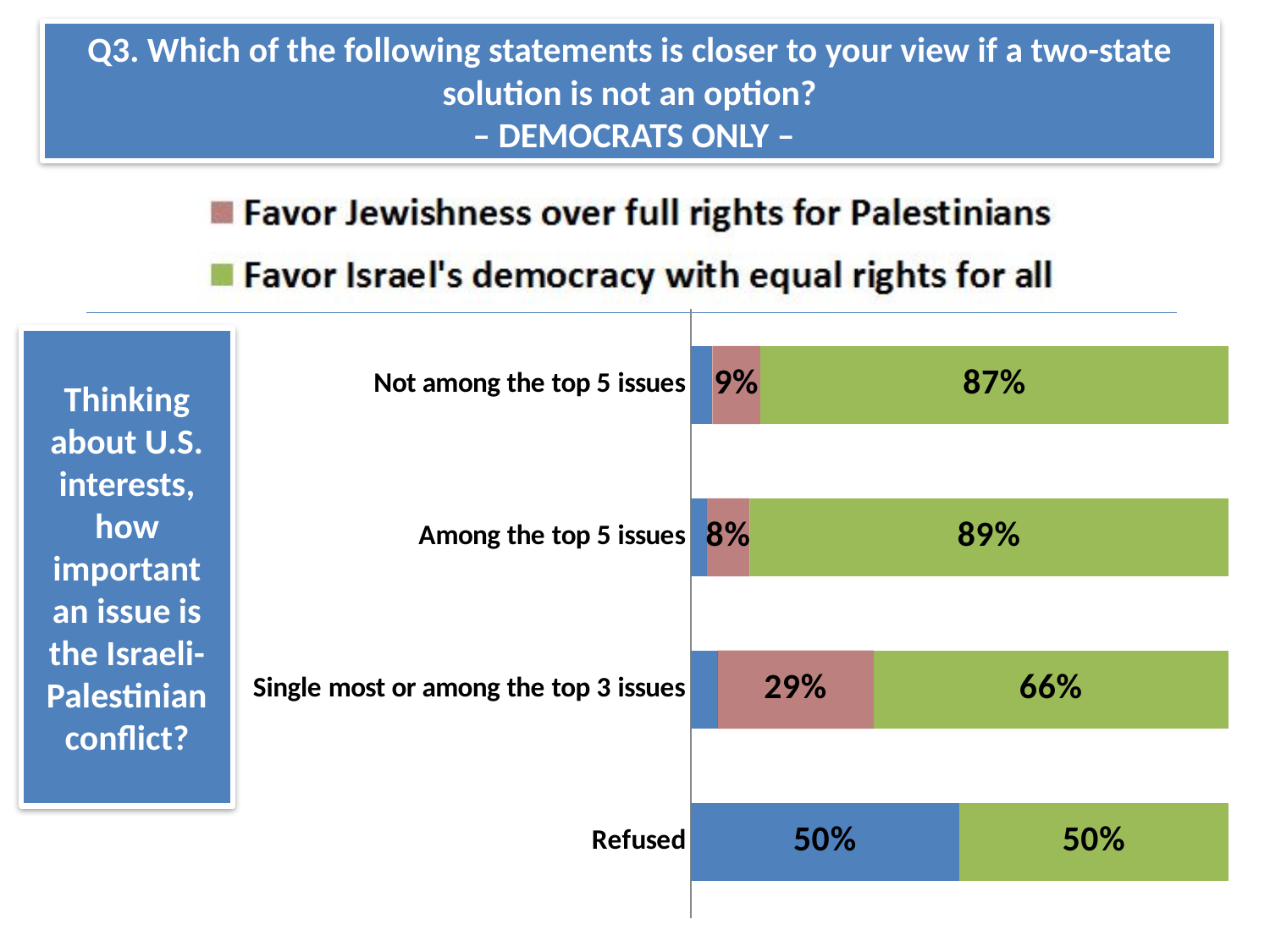
Which category has a larger 'Favor Jewishness over full rights for Palestinians' value: 'Not among the top 5 issues' or 'Single most or among the top 3 issues'? Single most or among the top 3 issues What kind of chart is shown on the slide? Stacked bar chart Which category has the highest value for 'Favor Israel's democracy with equal rights for all'? Among the top 5 issues What percentage of Democrats who say the conflict is not among the top 5 issues favor Israel's democracy with equal rights for all? 87% What is the value for 'Favor Israel's democracy with equal rights for all' in the 'Refused' category? 50% What is the difference in percentage points between the 'Favor Israel's democracy with equal rights for all' values for 'Among the top 5 issues' and 'Single most or among the top 3 issues'? 23 percentage points What is the value for 'Favor Jewishness over full rights for Palestinians' in the 'Single most or among the top 3 issues' category? 29% How many categories are shown on the chart? 4 Which category has the lowest value for 'Favor Israel's democracy with equal rights for all'? Refused How many series does the legend list? 2 Which category has the highest value for 'Favor Jewishness over full rights for Palestinians'? Single most or among the top 3 issues What percentage of Democrats who say the conflict is among the top 5 issues favor Jewishness over full rights for Palestinians? 8%